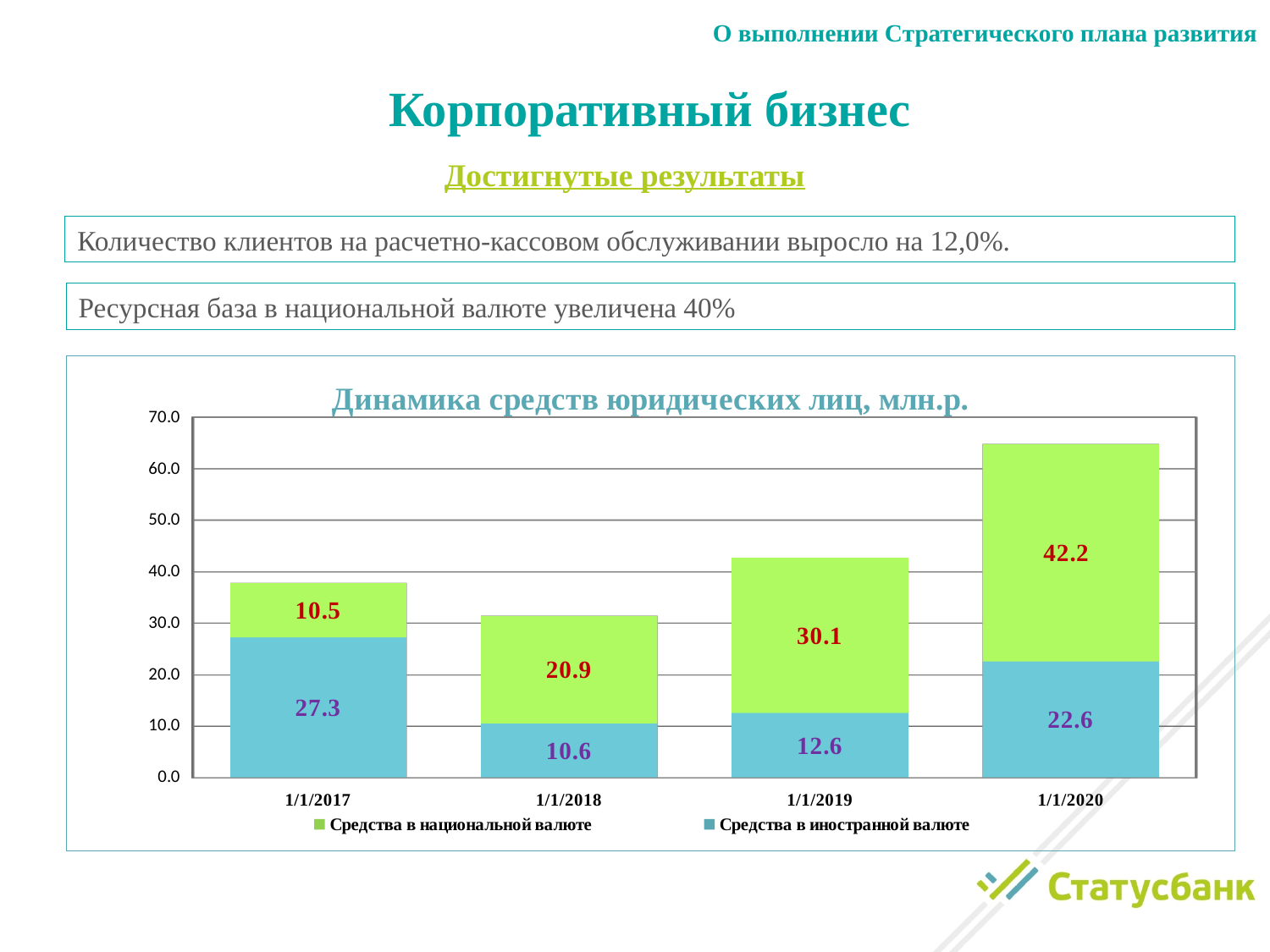
What is the value of 'Средства в иностранной валюте' for 1/1/2017? 27.3 Does 'Средства в национальной валюте' rise or fall from 1/1/2017 to 1/1/2020? Rise What is the value of 'Средства в иностранной валюте' for 1/1/2018? 10.6 Which date has the highest value for 'Средства в национальной валюте'? 1/1/2020 What is the total of the stacked bar for 1/1/2020? 64.8 Which date has the lowest value for 'Средства в иностранной валюте'? 1/1/2018 What is the difference between 'Средства в национальной валюте' for 1/1/2020 and 1/1/2019? 12.1 What type of chart is shown on the slide? Stacked bar chart How many dates are shown on the x axis? 4 Which is larger for 1/1/2017: 'Средства в национальной валюте' or 'Средства в иностранной валюте'? Средства в иностранной валюте How many series does the legend list? 2 What is the value of 'Средства в национальной валюте' for 1/1/2020? 42.2